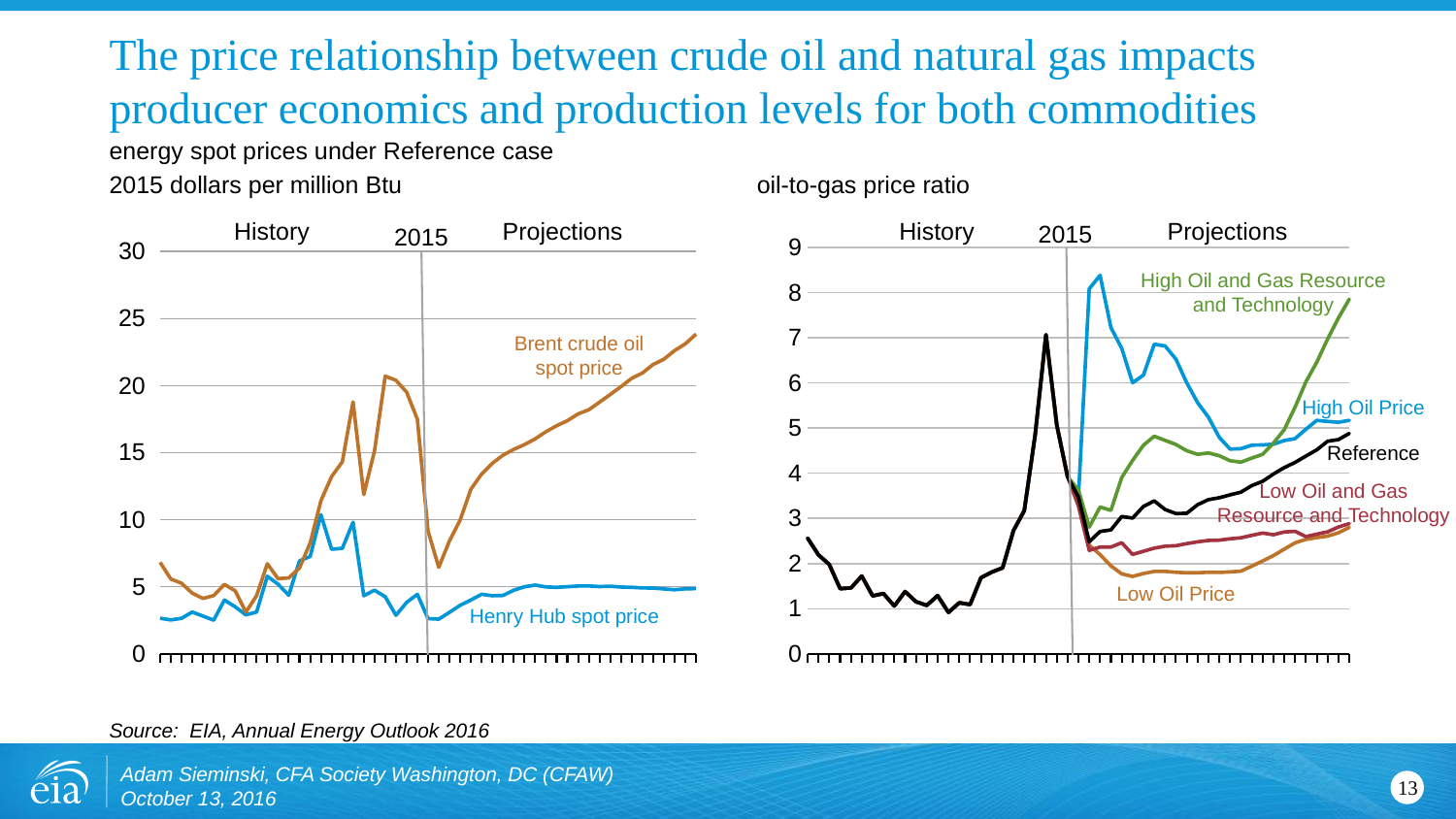
On the right chart, is the High Oil and Gas Resource and Technology ratio at the end of the projection period greater or less than 7? greater On the left chart, does the Brent crude oil spot price rise or fall over the projection period? rise On the right chart, is the lowest point of the Low Oil Price series greater or less than 2? less What kind of chart is the left chart, 'energy spot prices under Reference case'? line chart On the right chart, which series has the highest oil-to-gas price ratio at the end of the projection period? High Oil and Gas Resource and Technology On the left chart, which series is higher at the end of the projection period, Brent crude oil spot price or Henry Hub spot price? Brent crude oil spot price How many series are plotted on the left chart, 'energy spot prices under Reference case'? 2 What unit is given for the left chart's values? 2015 dollars per million Btu On the left chart, is the Brent crude oil spot price at the end of the projection period greater or less than 20? greater How many series are plotted on the right chart, 'oil-to-gas price ratio'? 5 On the right chart, does the Reference oil-to-gas price ratio rise or fall over the projection period? rise